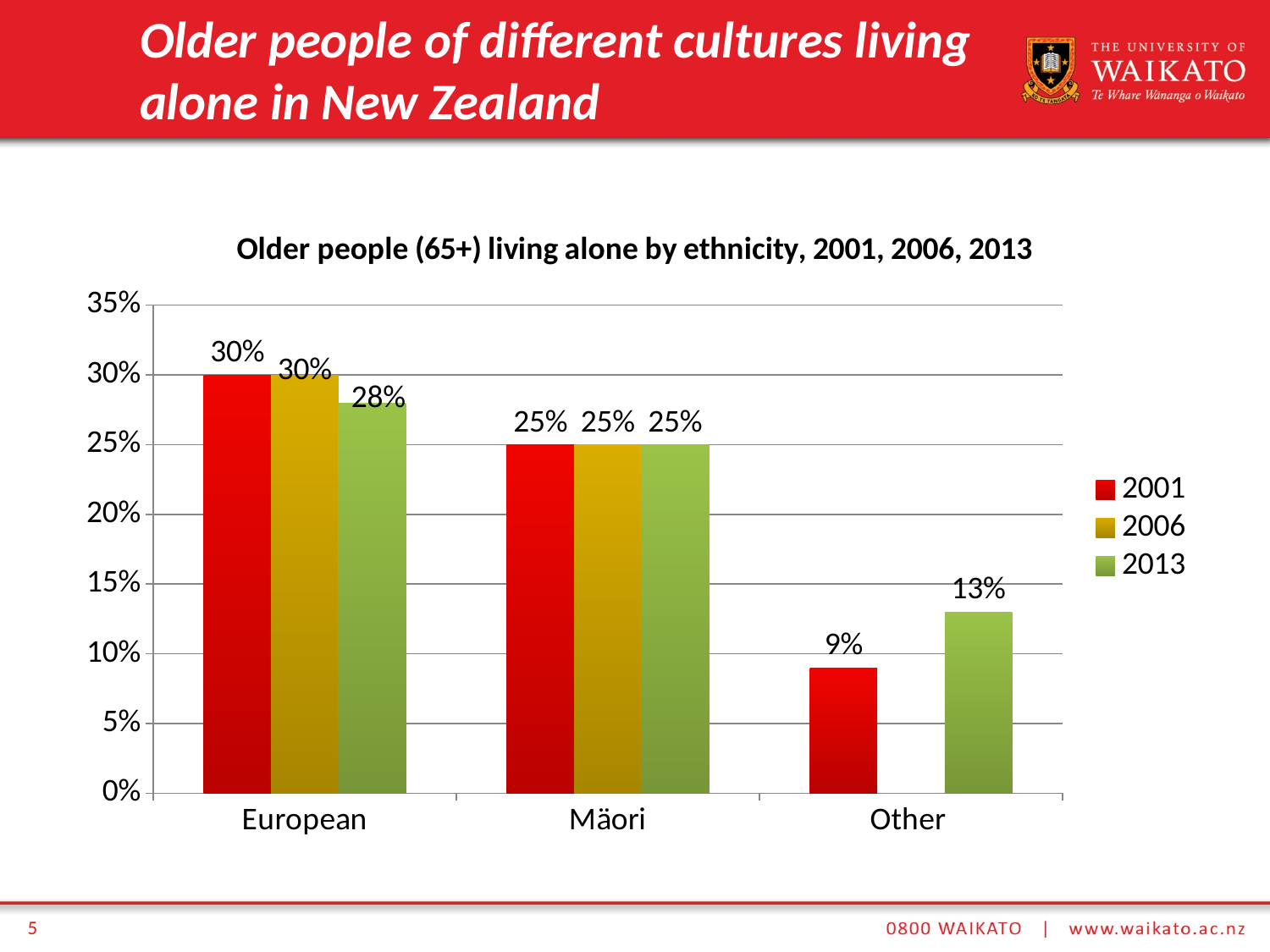
What is the title of the chart? Older people (65+) living alone by ethnicity, 2001, 2006, 2013 What percentage of older Māori people lived alone in 2013? 25% What percentage of older European people lived alone in 2001? 30% Which ethnic group has the highest value in 2013? European Which is larger: the Māori value in 2006 or the Other value in 2013? Māori value in 2006 What is the value for the Other group in 2013? 13% What is the difference between the European value in 2001 and the European value in 2013? 2% How many series does the legend list? 3 Which ethnic group has the lowest value in 2001? Other What is the difference between the Other group's value in 2013 and its value in 2001? 4% What is the value for the Other group in 2001? 9% What type of chart is shown on the slide? Bar chart